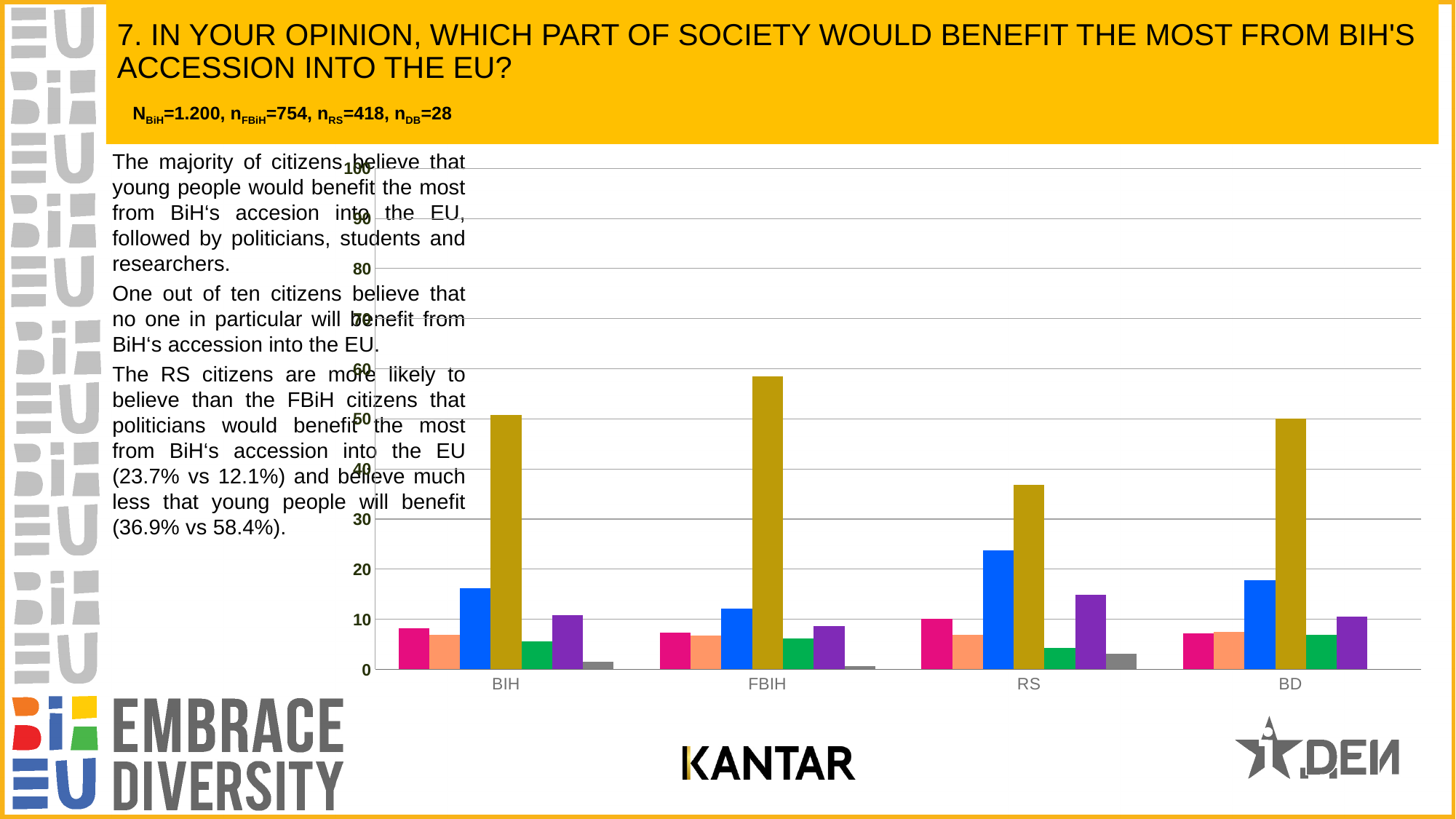
Which category has the shortest gold bar? RS How many categories are shown on the x axis of the chart? 4 Is the gold bar for RS greater or less than 40? less Which category has the tallest gold bar? FBIH How many bars are plotted for each category on the chart? 7 Is the blue bar for FBIH greater or less than 20? less What is the highest value shown on the vertical axis of the chart? 100 What kind of chart is shown on the slide? bar chart Which is larger, the purple bar for RS or the purple bar for BIH? RS Which is larger, the blue bar for RS or the blue bar for FBIH? RS Is the gold bar for FBIH greater or less than 50? greater